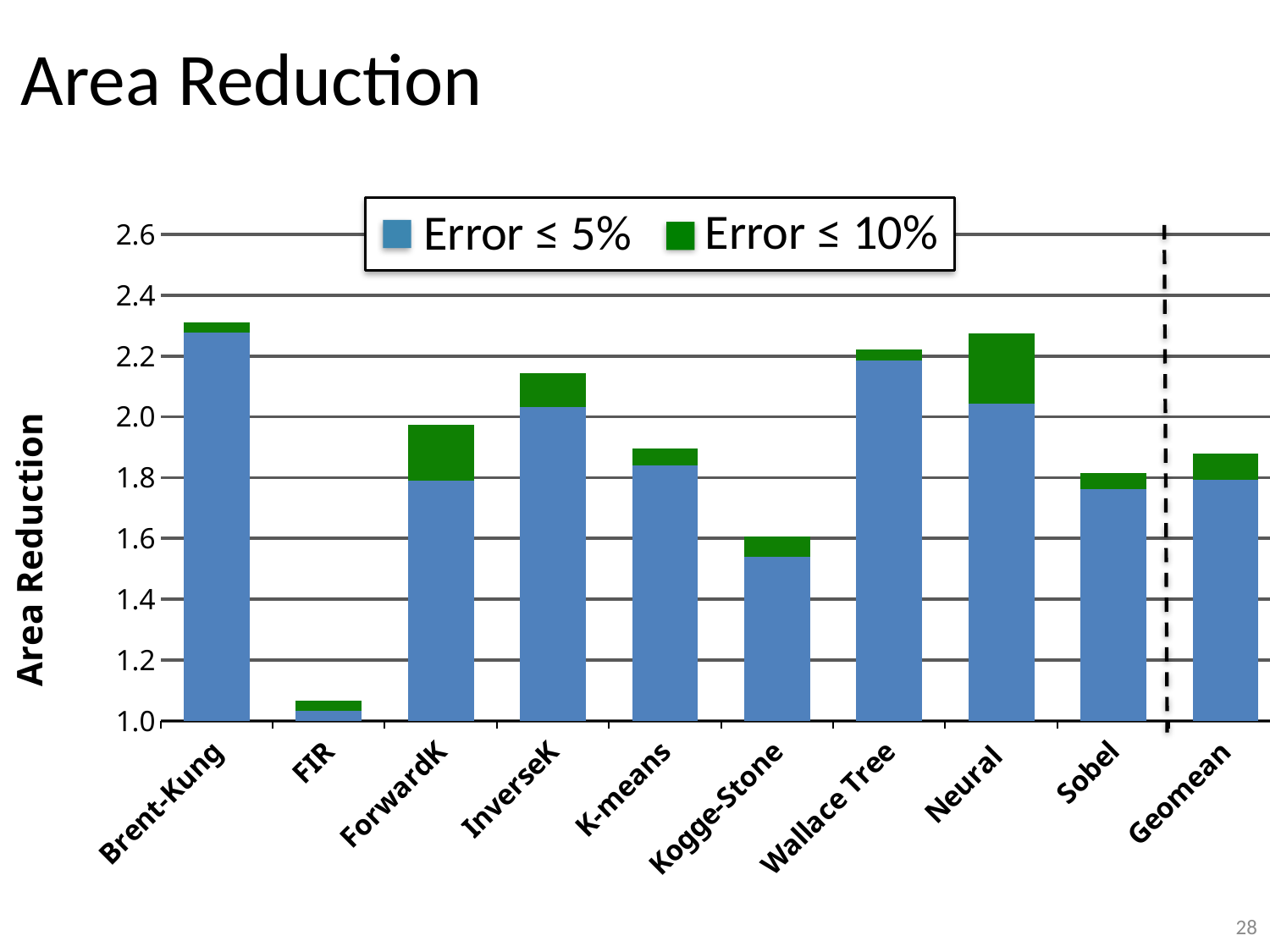
What is the label on the y axis of the chart? Area Reduction Which has a larger total area reduction, Wallace Tree or Kogge-Stone? Wallace Tree Is the Error ≤ 5% value for Wallace Tree greater or less than 2.0? greater Is the Error ≤ 5% value for Kogge-Stone greater or less than 1.6? less Is the total area reduction for FIR greater or less than 1.2? less What kind of chart is shown on the slide? bar chart Which category has the lowest area reduction? FIR Which category has the largest Error ≤ 10% (green) segment? Neural How many categories are shown along the x axis of the chart? 10 How many series does the chart's legend list? 2